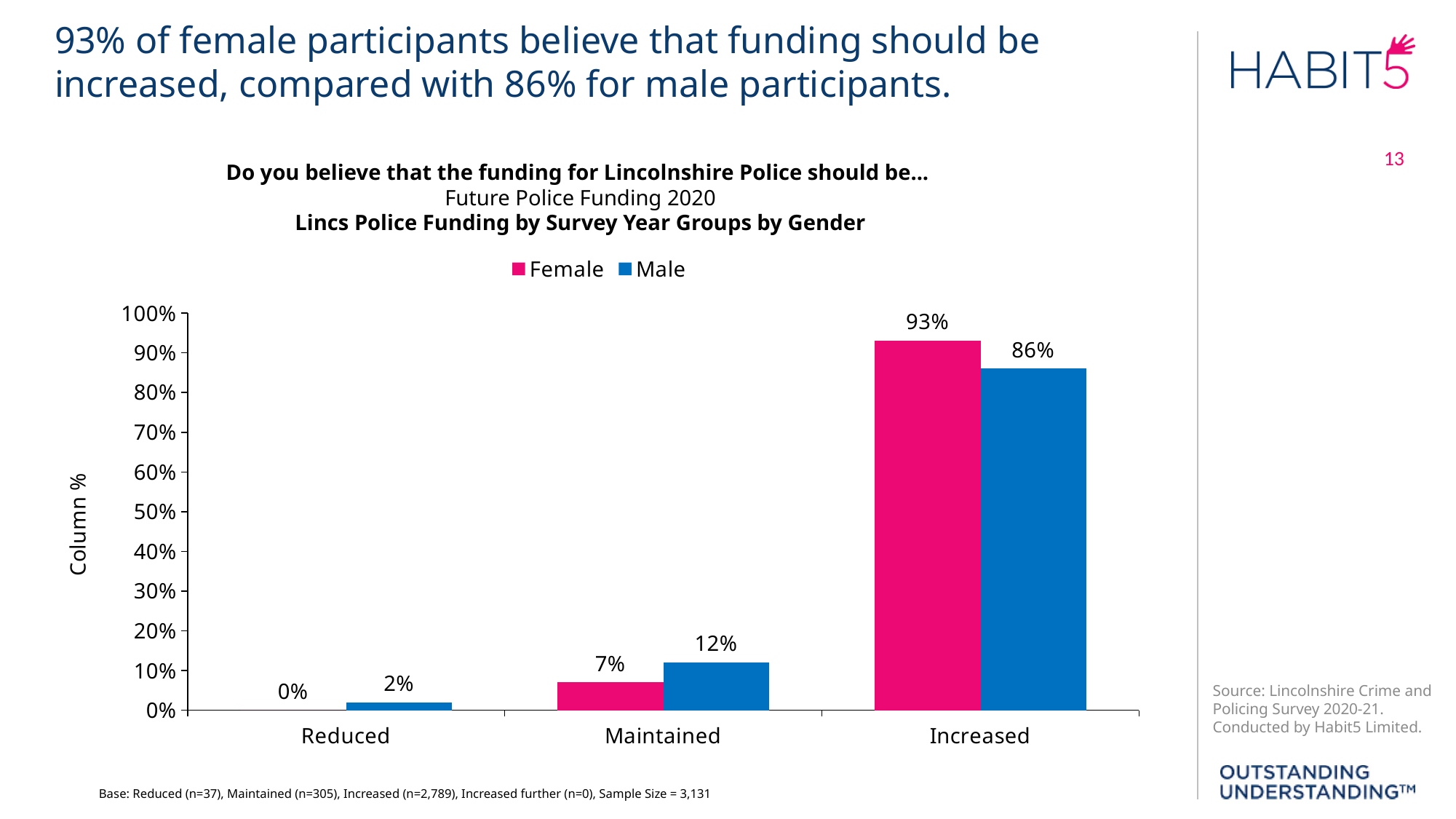
What percentage of male participants believe funding should be Maintained? 12% What is the difference between the Female and Male values for Increased? 7% What colour represents the Female series in the chart? Pink How many series does the legend list? 2 What percentage of female participants believe funding should be Increased? 93% Which is larger for Maintained, the Female value or the Male value? Male What is the value for Male in the Reduced category? 2% How many categories are shown on the x axis? 3 What kind of chart is shown on the slide? Bar chart Which category has the lowest value for Female? Reduced What is the value for Female in the Reduced category? 0% Which category has the highest value for Male? Increased